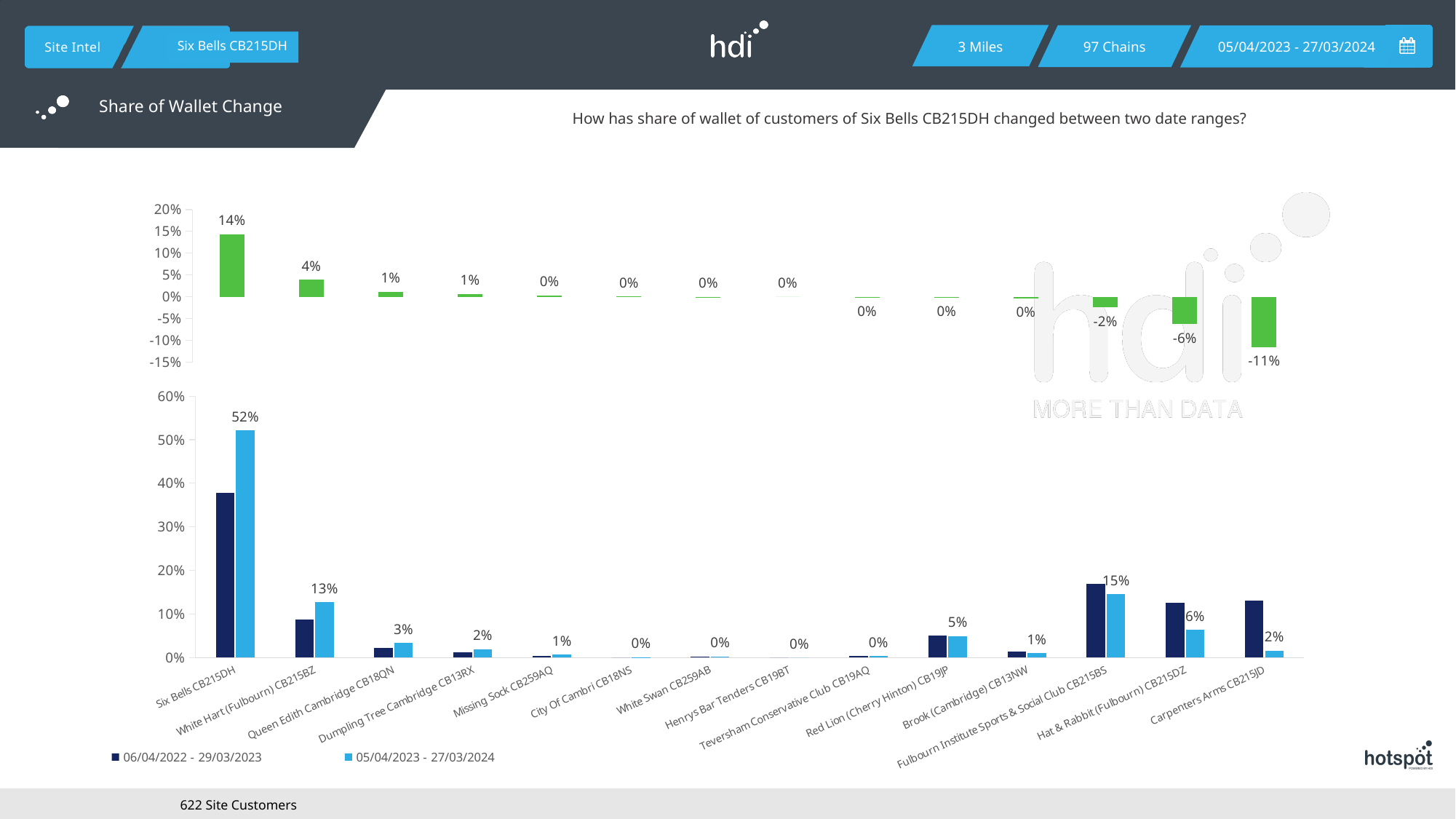
In the top chart, what is the share of wallet change for Six Bells CB215DH? 14% In the top chart, what is the share of wallet change for Hat & Rabbit (Fulbourn) CB215DZ? -6% How many categories are shown on the x axis of the bottom chart? 14 In the bottom chart, what is the value for Six Bells CB215DH in the 05/04/2023 - 27/03/2024 series? 52% In the top chart, which category has the lowest share of wallet change? Carpenters Arms CB215JD In the bottom chart, is the value for Six Bells CB215DH in the 06/04/2022 - 29/03/2023 series greater or less than 30%? greater What kind of chart is the top chart? bar chart In the bottom chart, what is the difference between Six Bells CB215DH and White Hart (Fulbourn) CB215BZ in the 05/04/2023 - 27/03/2024 series? 39% How many series does the legend of the bottom chart list? 2 In the bottom chart, which category has the highest value in the 05/04/2023 - 27/03/2024 series? Six Bells CB215DH In the bottom chart, which series has the larger value for Hat & Rabbit (Fulbourn) CB215DZ? 06/04/2022 - 29/03/2023 In the top chart, what is the difference between the values for Six Bells CB215DH and White Hart (Fulbourn) CB215BZ? 10%